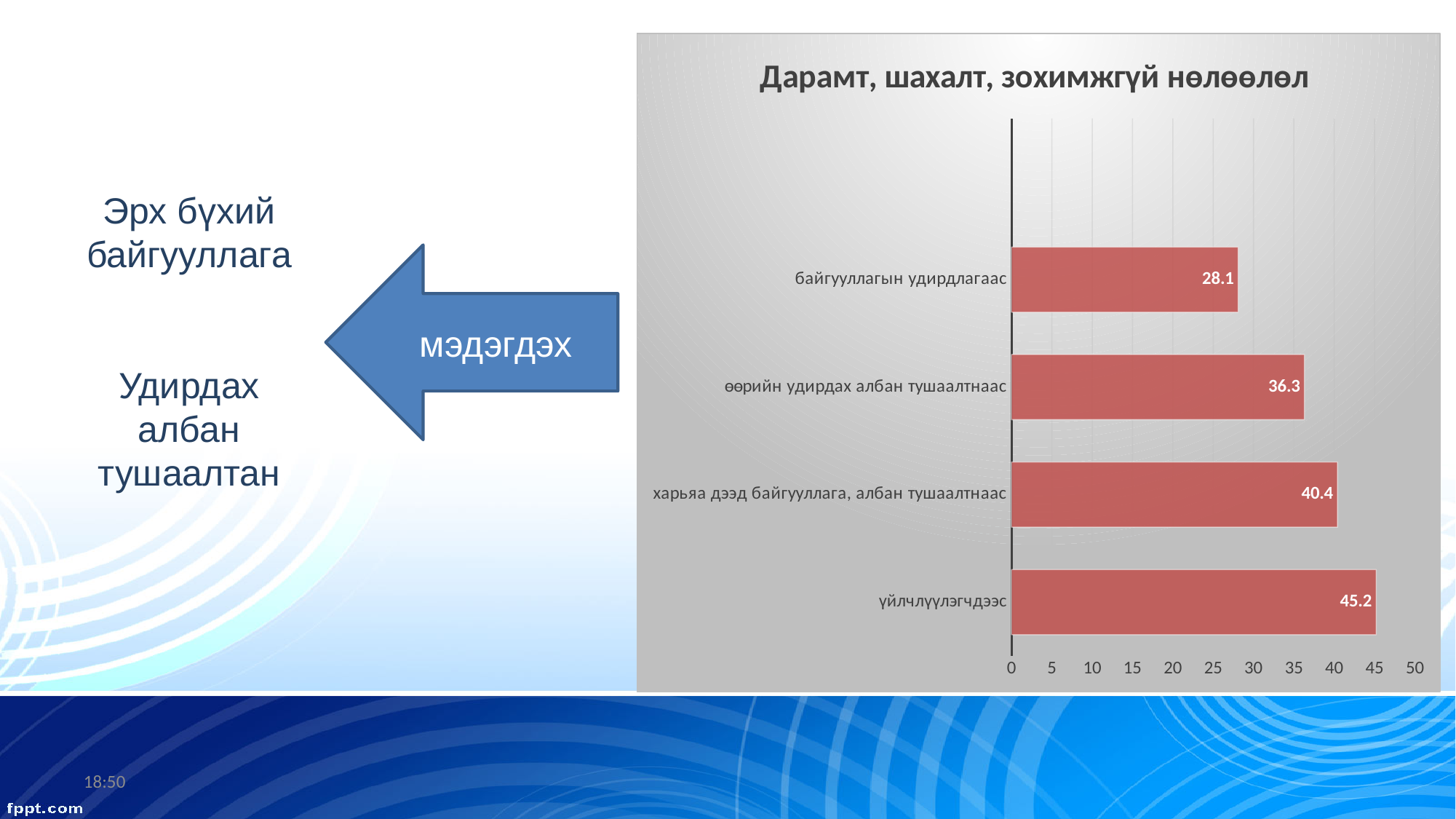
Is the value for өөрийн удирдах албан тушаалтнаас greater or less than 35? greater What is the value for харьяа дээд байгууллага, албан тушаалтнаас? 40.4 Which is larger: the value for өөрийн удирдах албан тушаалтнаас or the value for харьяа дээд байгууллага, албан тушаалтнаас? харьяа дээд байгууллага, албан тушаалтнаас What is the value for байгууллагын удирдлагаас? 28.1 Which category has the lowest value? байгууллагын удирдлагаас What is the value for өөрийн удирдах албан тушаалтнаас? 36.3 Which category has the highest value? үйлчлүүлэгчдээс How many categories are shown in the chart? 4 What is the title of the chart? Дарамт, шахалт, зохимжгүй нөлөөлөл What is the value for үйлчлүүлэгчдээс? 45.2 What kind of chart is shown on the slide? bar chart What is the difference between the values for үйлчлүүлэгчдээс and байгууллагын удирдлагаас? 17.1